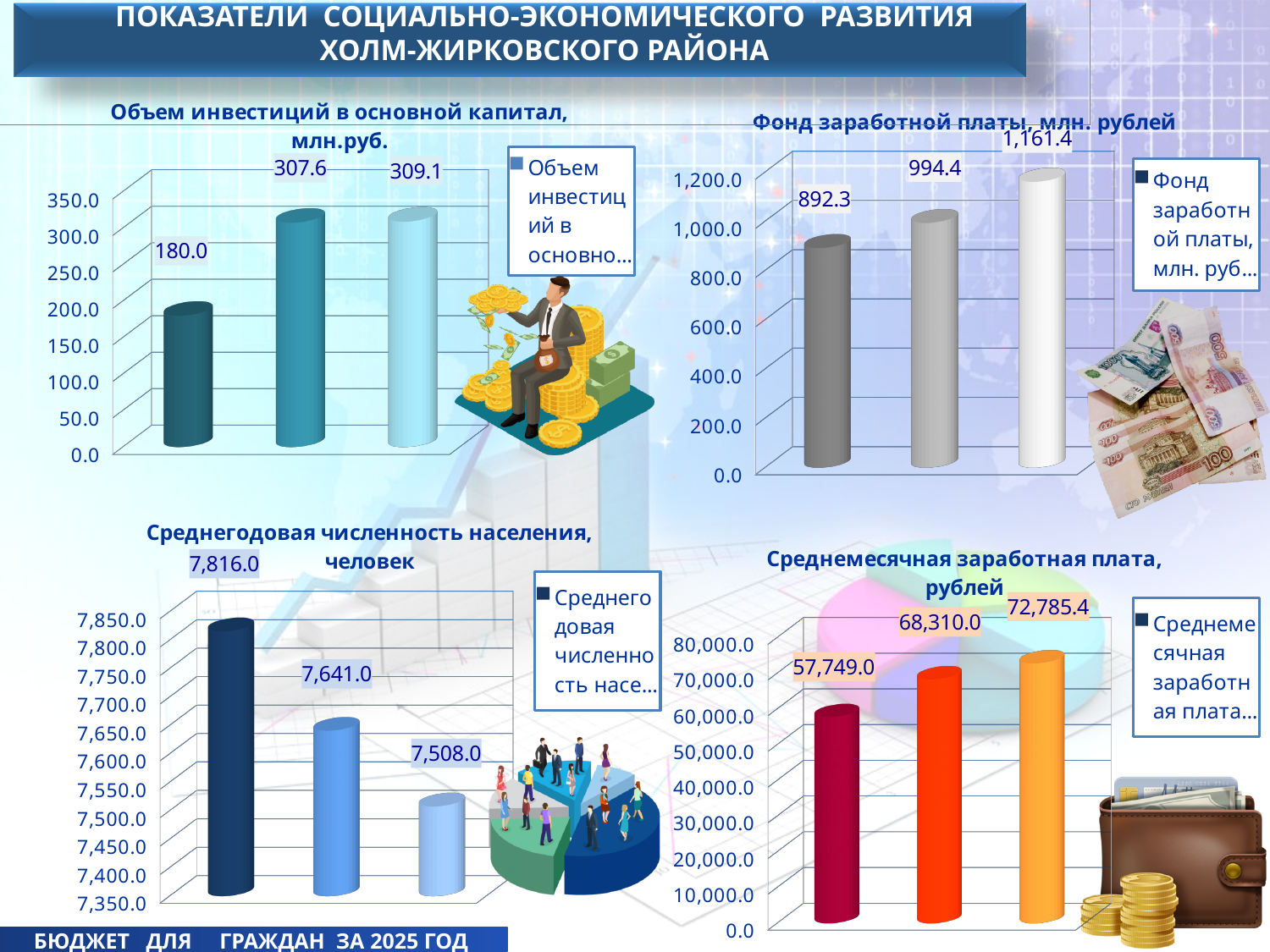
In the chart 'Среднегодовая численность населения, человек', what is the value of the second (middle) bar? 7,641.0 In the chart 'Среднегодовая численность населения, человек', do the values rise or fall from left to right? fall In the chart 'Среднемесячная заработная плата, рублей', what is the highest value shown? 72,785.4 How many bars are plotted in the chart 'Среднемесячная заработная плата, рублей'? 3 What type of chart is 'Объем инвестиций в основной капитал, млн.руб.'? bar chart In the chart 'Фонд заработной платы, млн. рублей', what is the difference between the second bar and the first bar? 102.1 In the chart 'Среднемесячная заработная плата, рублей', what is the difference between the second bar and the first bar? 10,561.0 In the chart 'Объем инвестиций в основной капитал, млн.руб.', what is the difference between the third bar and the second bar? 1.5 In the chart 'Фонд заработной платы, млн. рублей', what is the value of the third (rightmost) bar? 1,161.4 In the chart 'Среднегодовая численность населения, человек', what is the lowest value shown? 7,508.0 In the chart 'Объем инвестиций в основной капитал, млн.руб.', what is the value of the first (leftmost) bar? 180.0 In the chart 'Фонд заработной платы, млн. рублей', do the values rise or fall from left to right? rise